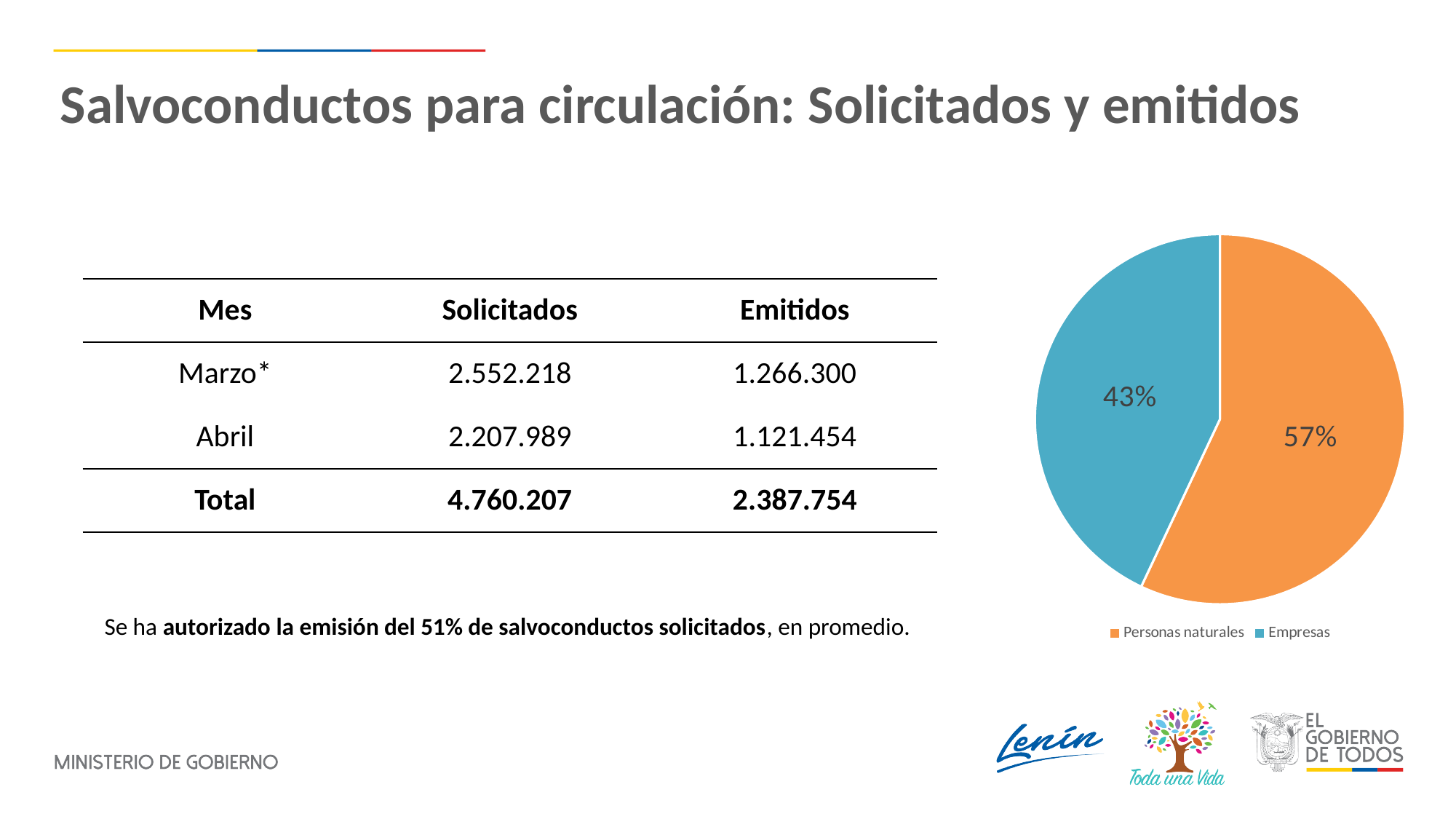
Is the Empresas share in the pie chart greater or less than 50%? less Which slice of the pie chart is the smallest? Empresas What share of the pie chart is labelled Empresas? 43% What share of the pie chart is labelled Personas naturales? 57% What colour is the Empresas slice in the pie chart? Blue Which slice of the pie chart is the largest? Personas naturales How many entries does the pie chart's legend list? 2 What kind of chart is shown on the right of the slide? Pie chart By how many percentage points does the Personas naturales slice exceed the Empresas slice? 14 percentage points How many slices does the pie chart have? 2 Which is larger in the pie chart, Personas naturales or Empresas? Personas naturales What colour is the Personas naturales slice in the pie chart? Orange